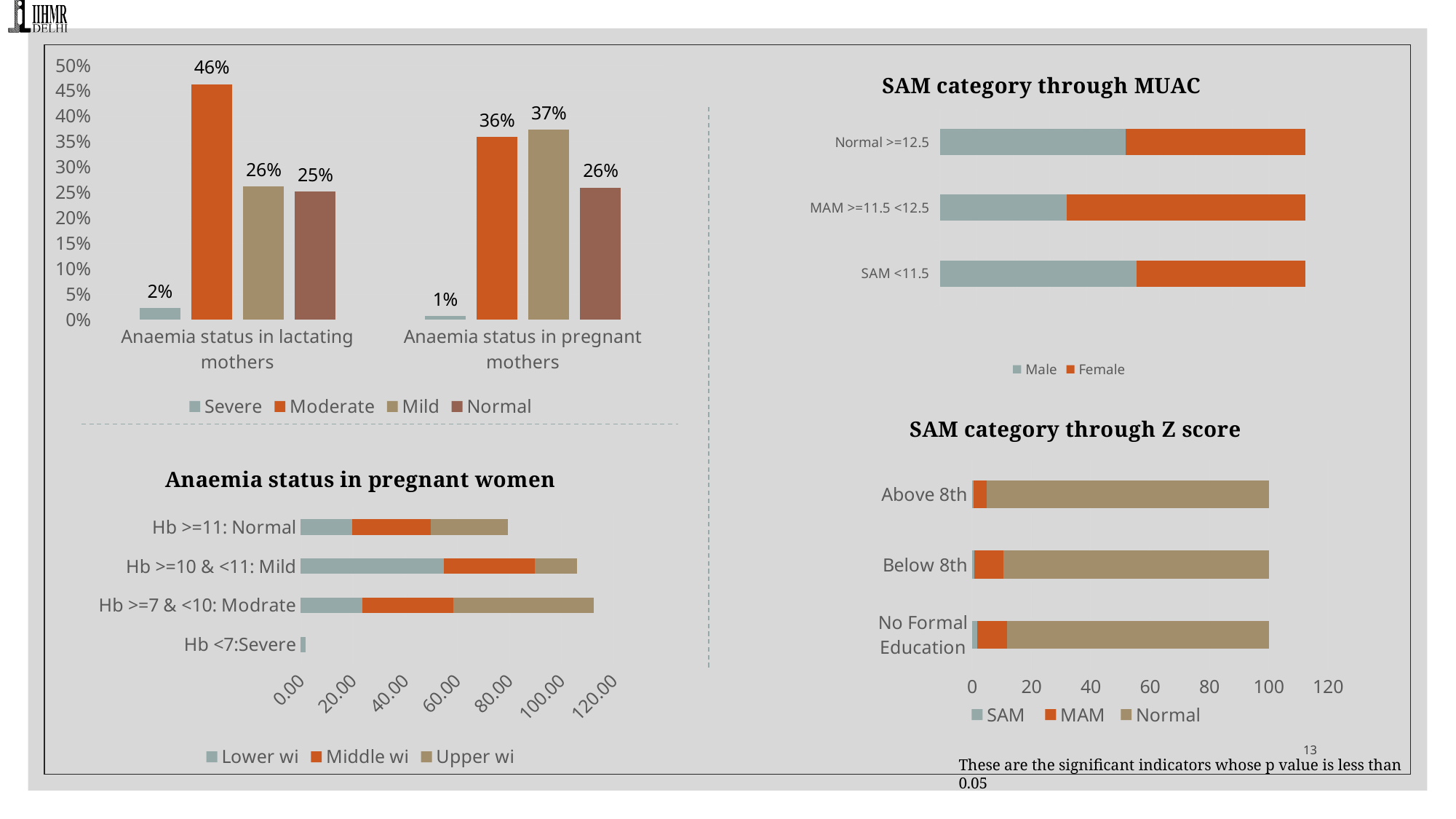
In the top-left chart, which anaemia category has the highest value for lactating mothers? Moderate In the chart titled 'Anaemia status in pregnant women', which is larger: the total bar for 'Hb >=7 & <10: Modrate' or the total bar for 'Hb <7:Severe'? Hb >=7 & <10: Modrate How many series does the legend of the top-left chart list? 4 In the chart titled 'SAM category through Z score', is the total length of the bar for 'Above 8th' greater or less than 80? greater In the top-left chart, what is the value for Mild anaemia status in pregnant mothers? 37% What are the legend entries in the chart titled 'SAM category through MUAC'? Male, Female In the top-left chart, which anaemia category has the lowest value for pregnant mothers? Severe In the chart titled 'SAM category through Z score', how many education categories are shown? 3 In the chart titled 'Anaemia status in pregnant women', how many Hb categories are shown? 4 What kind of chart is the top-left chart showing anaemia status in lactating and pregnant mothers? Bar chart In the top-left chart, what is the value for Moderate anaemia status in lactating mothers? 46% In the top-left chart, what is the difference between the Moderate value for lactating mothers and the Moderate value for pregnant mothers? 10%